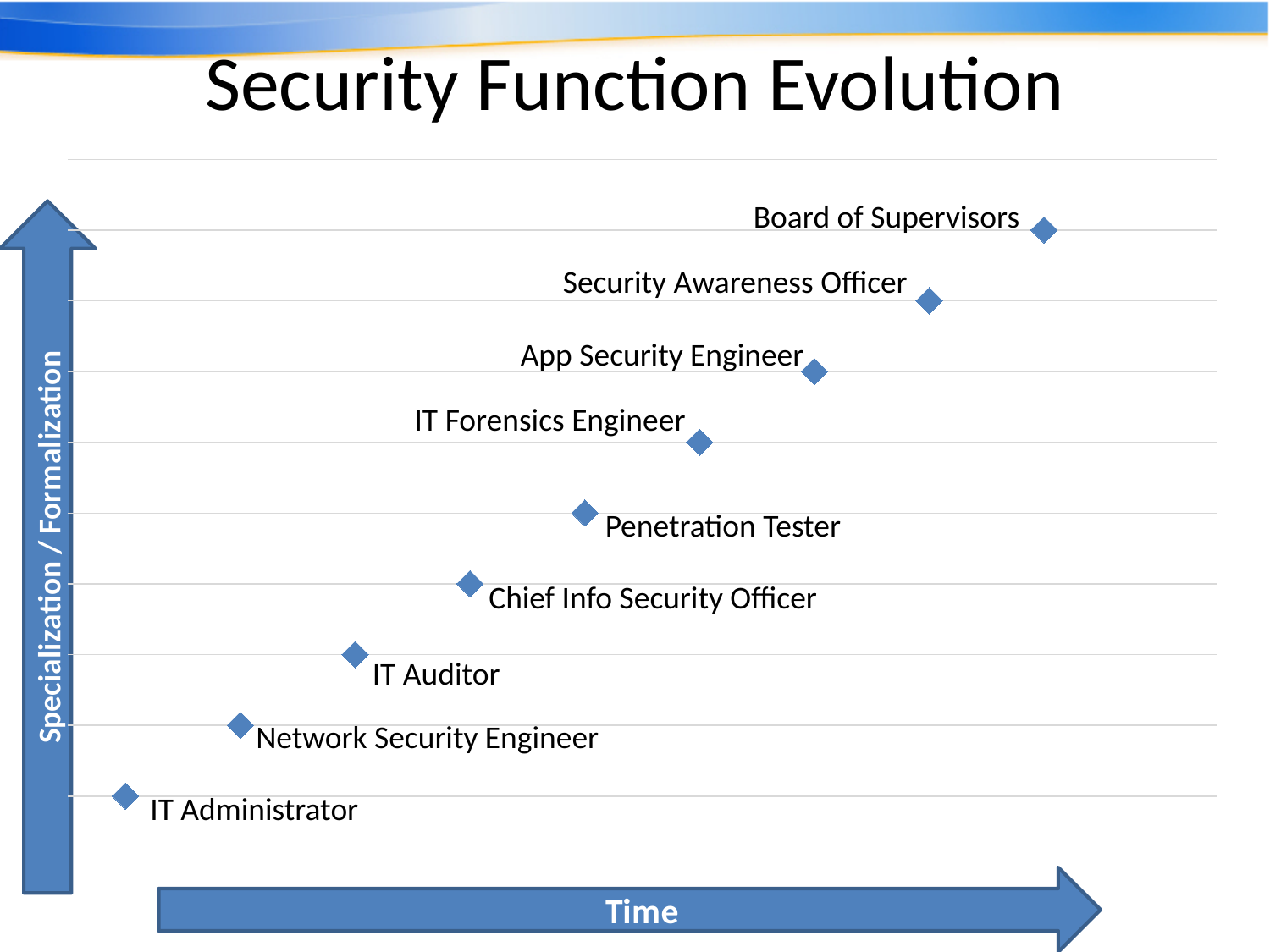
Do the points rise or fall as you move along the Time axis from left to right? Rise Which role is plotted highest on the Specialization / Formalization axis? Board of Supervisors How many data points are plotted on the chart? 9 Which role is plotted lowest on the Specialization / Formalization axis? IT Administrator Which role appears immediately after IT Administrator along the Time axis? Network Security Engineer What kind of chart is shown on the slide? Scatter chart What is the label on the vertical axis of the chart? Specialization / Formalization What is the label on the horizontal axis of the chart? Time Which role is plotted directly below Security Awareness Officer in the sequence? App Security Engineer Which is plotted further to the right along the Time axis, Penetration Tester or Network Security Engineer? Penetration Tester Which is plotted higher on the chart, App Security Engineer or IT Auditor? App Security Engineer